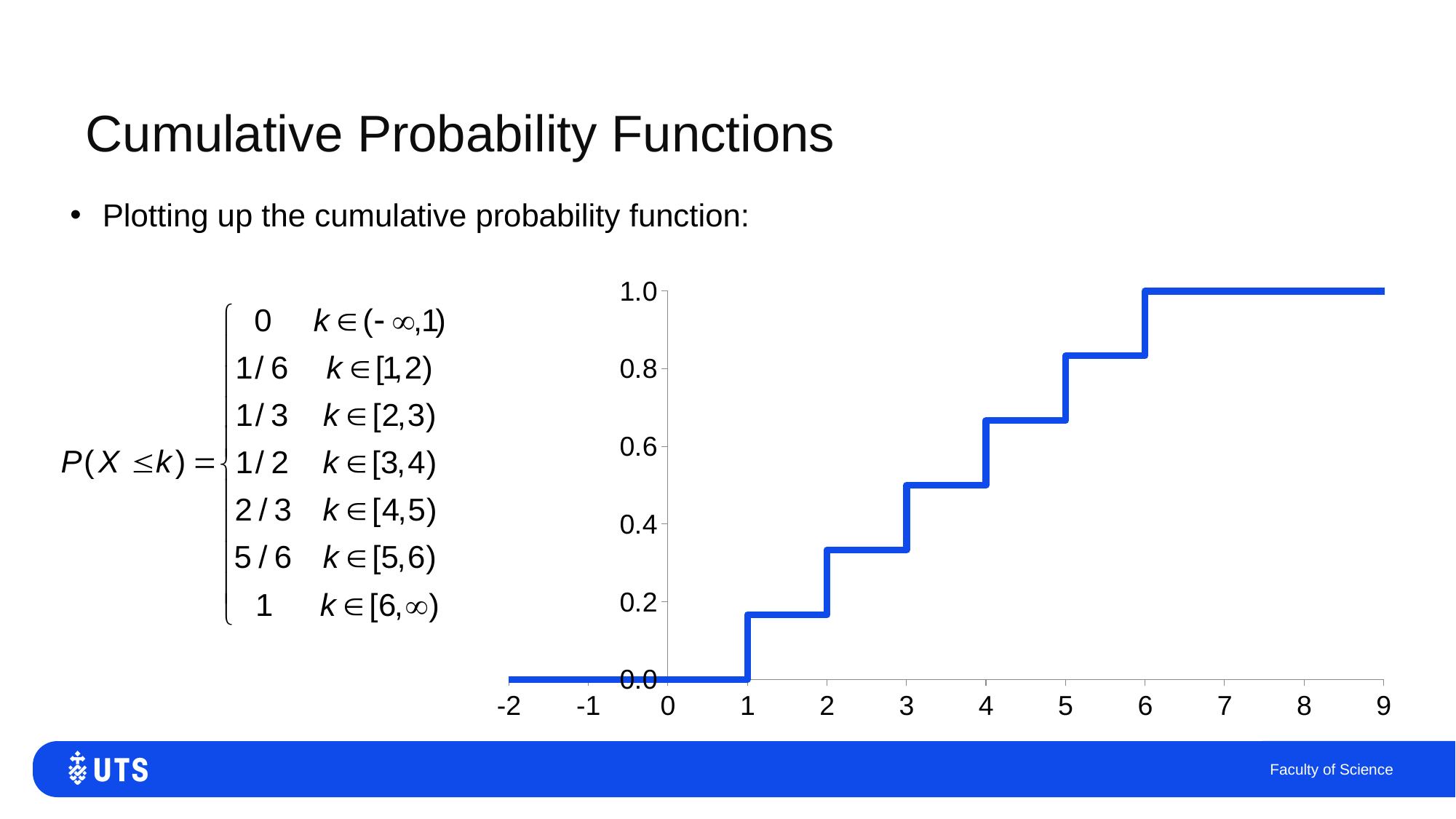
How many upward jumps (steps) does the plotted function have? 6 Is the value of the plotted function at k = 5.5 greater or less than 0.8? greater What kind of chart is shown on the slide? line chart What is the value of the plotted function at k = -1? 0.0 Do the plotted values rise or fall as k increases along the x axis? rise Is the value of the plotted function at k = 4.5 greater or less than 0.6? greater Is the value of the plotted function at k = 3.5 greater or less than 0.6? less What is the value of the plotted function at k = 8? 1.0 Which is larger: the plotted value at k = 2 or at k = 5? k = 5 What is the highest value the plotted function reaches? 1.0 What is the largest value labelled on the x axis? 9